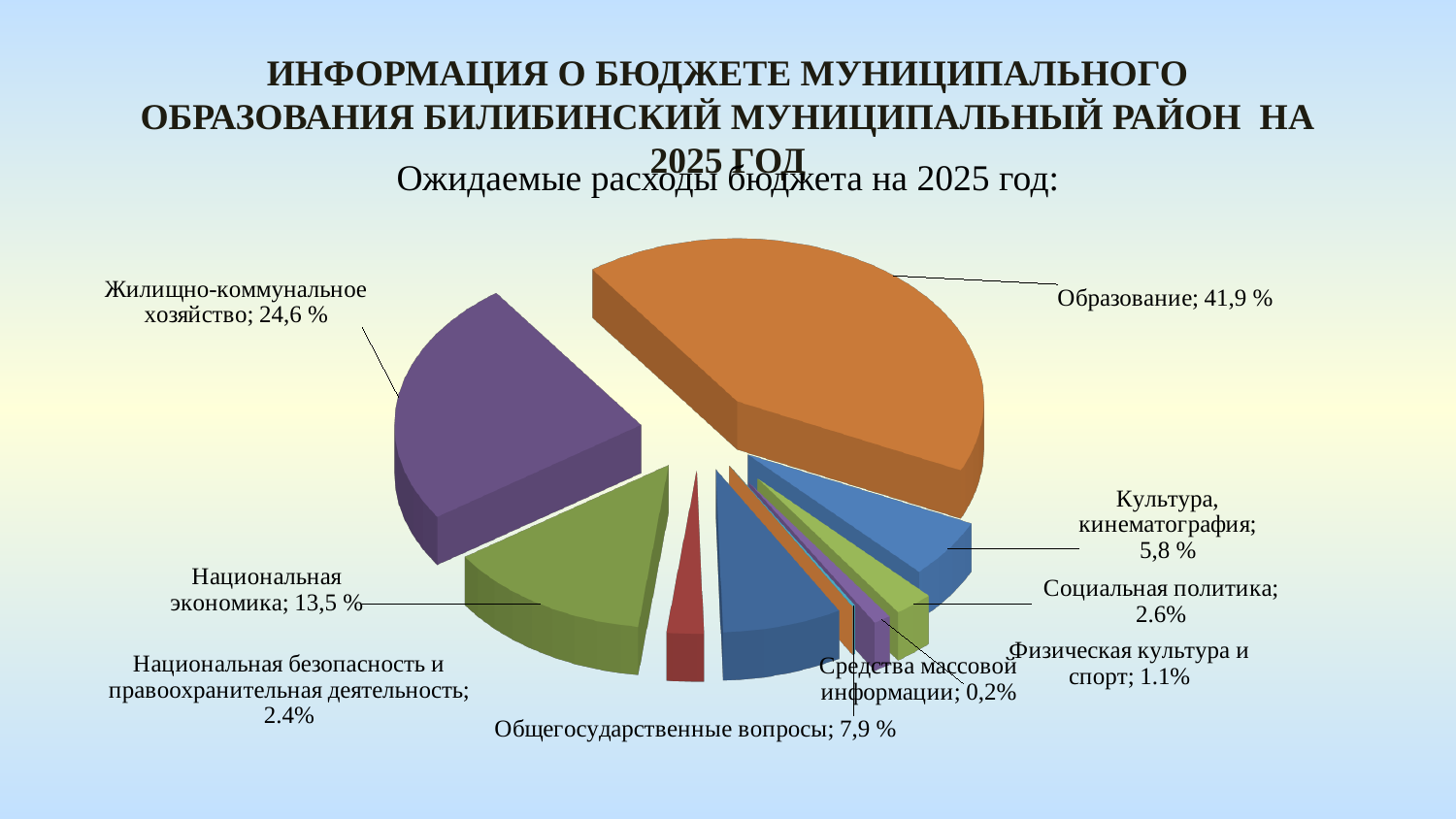
What is the value shown for Культура, кинематография? 5,8 % What is the difference between the shares of Образование and Жилищно-коммунальное хозяйство? 17,3 % What is the value shown for Национальная экономика? 13,5 % Which category has the smallest share of the pie? Средства массовой информации What is the value shown for Средства массовой информации? 0,2% What type of chart is shown on the slide? Pie chart What is the value shown for Общегосударственные вопросы? 7,9 % What is the share of Образование in the pie chart? 41,9 % How many categories are shown in the pie chart? 9 Which is larger: Социальная политика or Национальная безопасность и правоохранительная деятельность? Социальная политика What is the share of Жилищно-коммунальное хозяйство? 24,6 % Which category has the largest share of the pie? Образование